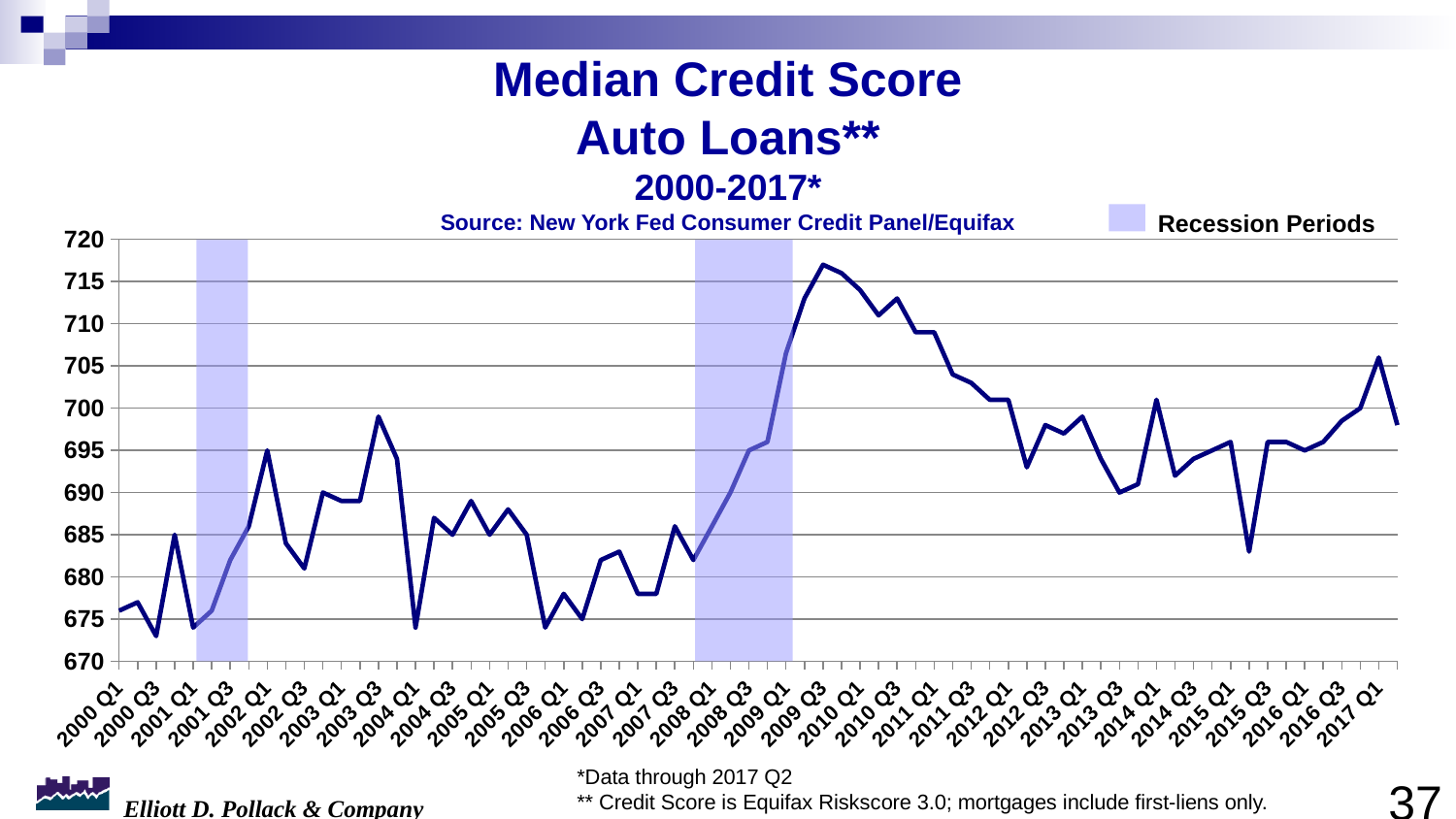
Does the median credit score rise or fall between 2008 Q1 and 2009 Q3? rise What is the title of the chart? Median Credit Score Auto Loans** 2000-2017* Is the value for 2015 Q3 greater or less than 685? greater Is the value for 2017 Q1 greater or less than 700? greater Which is larger, the value for 2003 Q3 or the value for 2004 Q1? 2003 Q3 Is the value for 2000 Q1 greater or less than 680? less Does the median credit score rise or fall between 2009 Q3 and 2013 Q3? fall What do the shaded vertical bands on the chart represent, according to the legend? Recession Periods What kind of chart is shown on the slide? line chart In which quarter does the median credit score reach its highest point? 2009 Q3